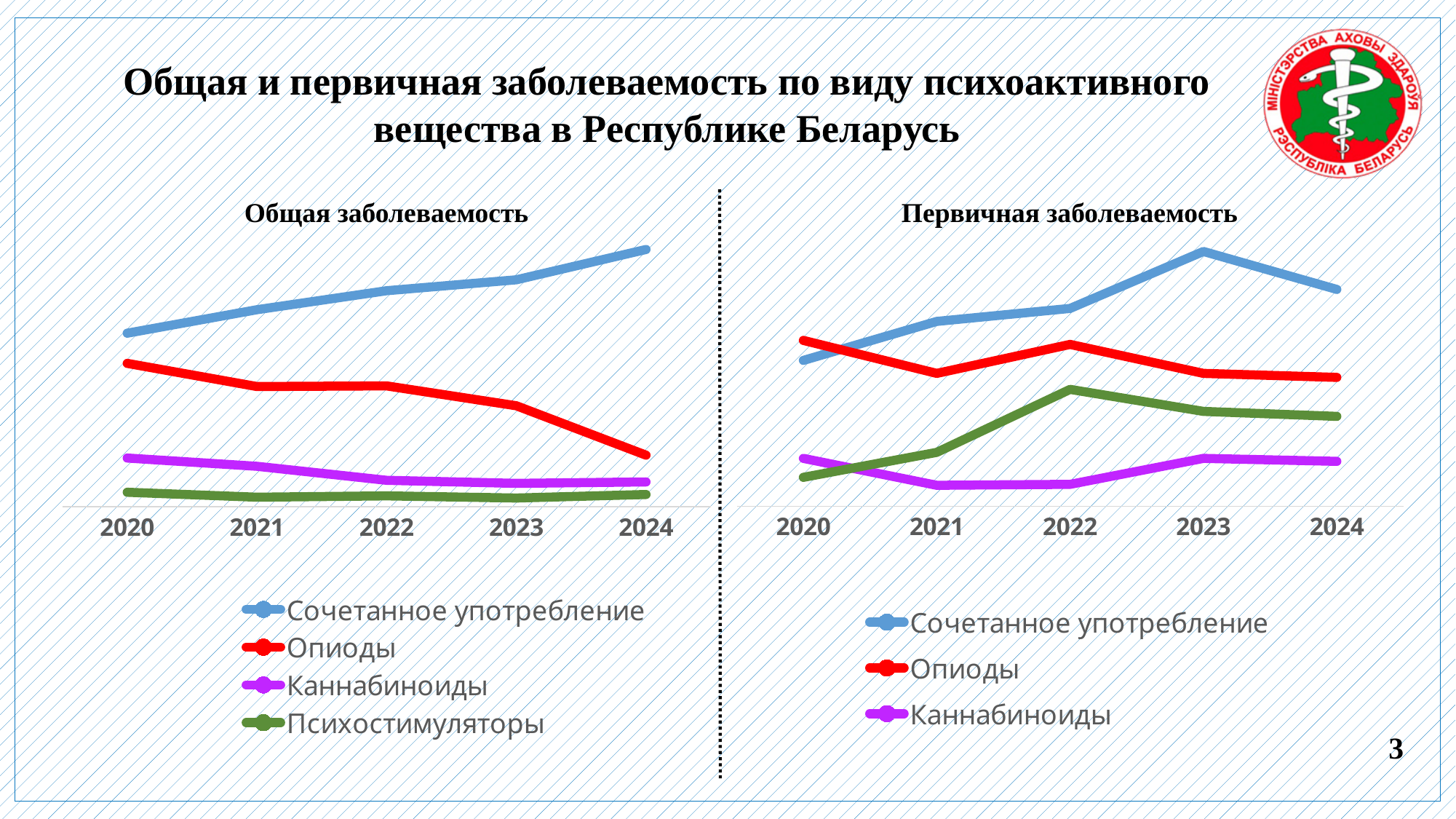
In the "Общая заболеваемость" chart on the left, which series has the highest value in 2024? Сочетанное употребление In the "Первичная заболеваемость" chart on the right, which series has the highest value in 2023? Сочетанное употребление In the "Общая заболеваемость" chart on the left, does the "Сочетанное употребление" line rise or fall from 2020 to 2024? rise In the "Первичная заболеваемость" chart on the right, which series has the lowest value in 2021? Каннабиноиды What kind of chart is the "Общая заболеваемость" chart on the left? line chart In the "Первичная заболеваемость" chart on the right, is the "Сочетанное употребление" value in 2024 higher or lower than in 2023? lower In the "Общая заболеваемость" chart on the left, which series has the lowest value in 2020? Психостимуляторы How many series does the legend of the "Общая заболеваемость" chart on the left list? 4 How many years are shown on the x axis of the "Первичная заболеваемость" chart on the right? 5 What is the title of the slide? Общая и первичная заболеваемость по виду психоактивного вещества в Республике Беларусь In the "Общая заболеваемость" chart on the left, does the "Опиоды" line rise or fall from 2020 to 2024? fall How many series does the legend of the "Первичная заболеваемость" chart on the right list? 3